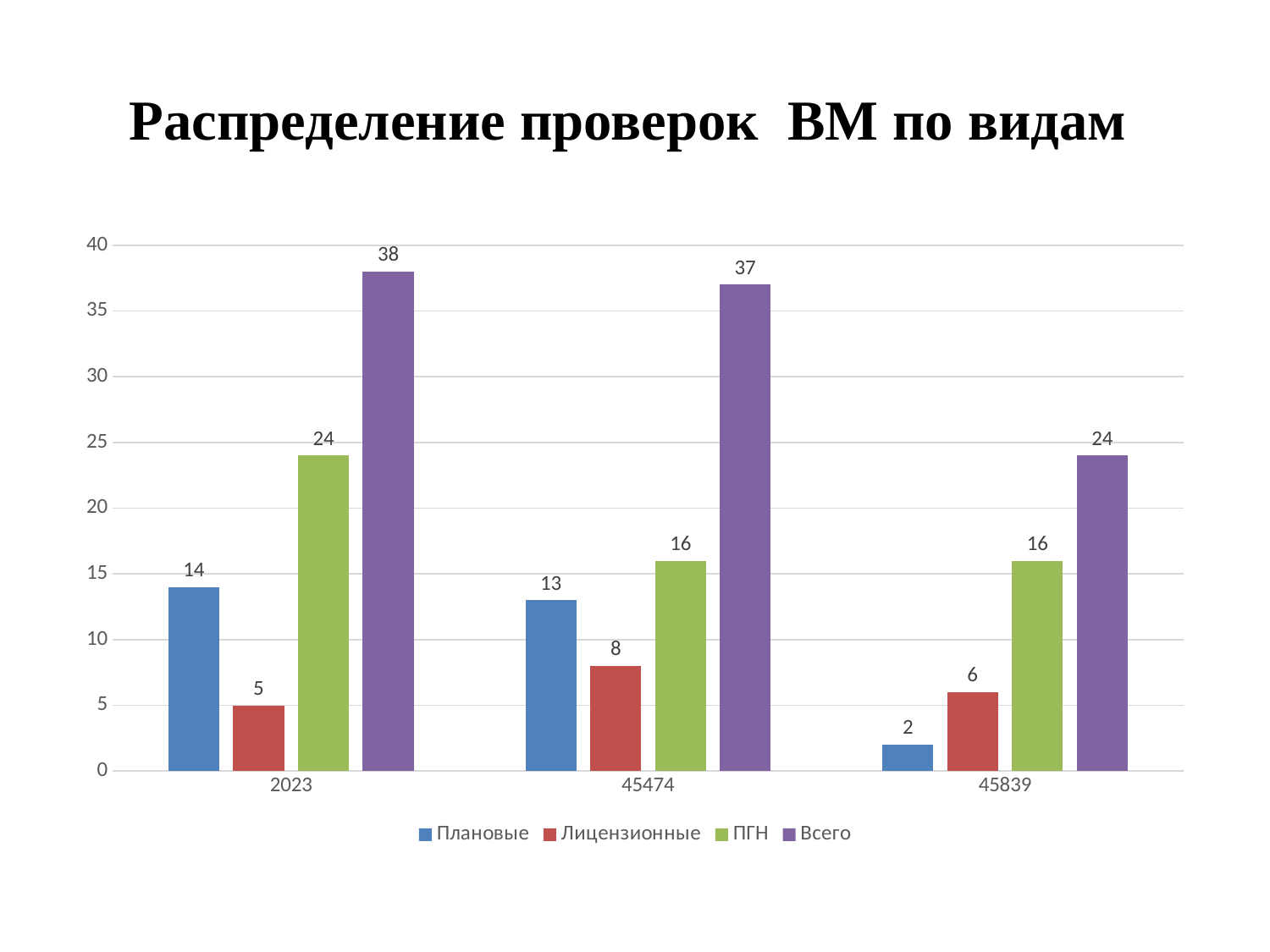
What kind of chart is shown on the slide? Bar chart What is the value of Плановые for the category 2023? 14 How many series does the legend list? 4 Which category has the highest value for Всего? 2023 What is the difference between the Всего values for 2023 and 45839? 14 What is the value of Лицензионные for the category 45474? 8 What is the title of the chart? Распределение проверок ВМ по видам Which category has the lowest value for Плановые? 45839 What is the value of ПГН for the category 45839? 16 Which is larger: Лицензионные for 45839 or Лицензионные for 2023? Лицензионные for 45839 How many categories are shown on the x axis? 3 Do the Всего values rise or fall from 2023 to 45839? Fall